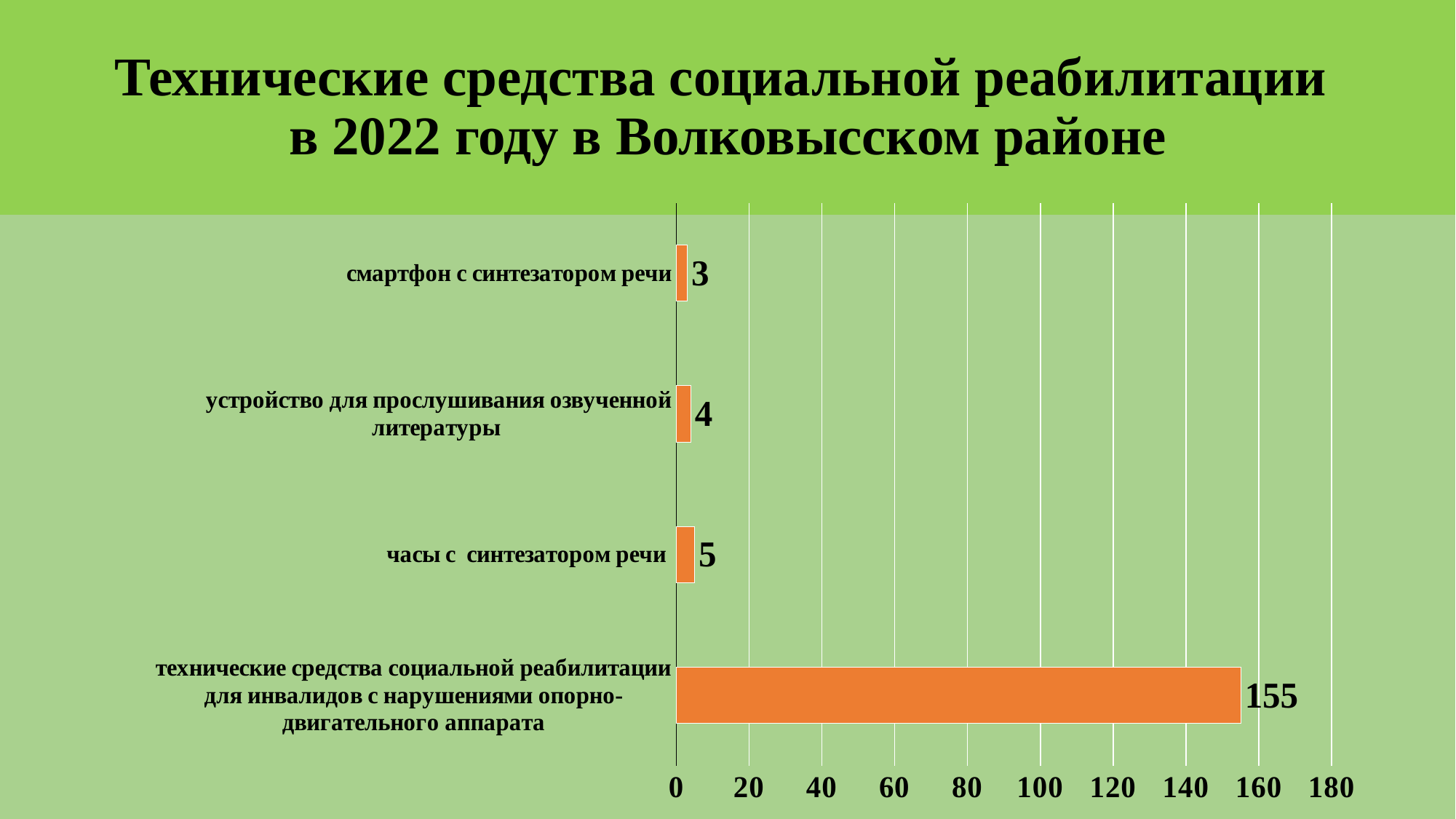
What is the value for "устройство для прослушивания озвученной литературы"? 4 What is the value for "технические средства социальной реабилитации для инвалидов с нарушениями опорно-двигательного аппарата"? 155 What is the difference between the value for "технические средства социальной реабилитации для инвалидов с нарушениями опорно-двигательного аппарата" and the value for "часы с синтезатором речи"? 150 Which category has the lowest value? смартфон с синтезатором речи What is the value for "часы с синтезатором речи"? 5 How many categories are shown in the chart? 4 Is the value for "технические средства социальной реабилитации для инвалидов с нарушениями опорно-двигательного аппарата" greater or less than 140? greater What is the value for "смартфон с синтезатором речи"? 3 What kind of chart is shown on the slide? bar chart What is the difference between the value for "часы с синтезатором речи" and the value for "смартфон с синтезатором речи"? 2 Which category has the highest value? технические средства социальной реабилитации для инвалидов с нарушениями опорно-двигательного аппарата Which is larger: the value for "часы с синтезатором речи" or the value for "устройство для прослушивания озвученной литературы"? часы с синтезатором речи